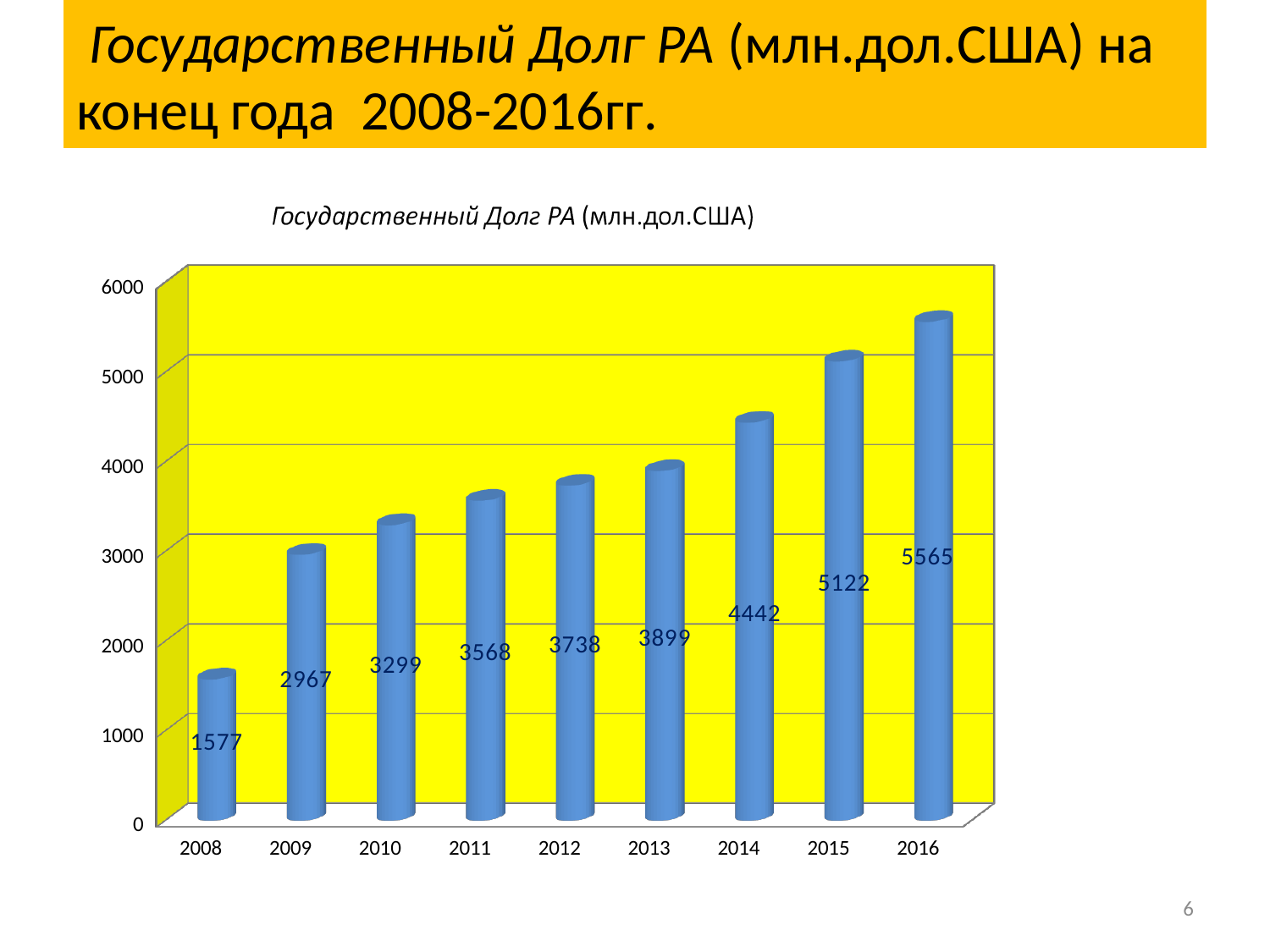
Do the values rise or fall from 2008 to 2016? rise What is the difference between the values for 2016 and 2008? 3988 What kind of chart is shown on the slide? bar chart Is the value for 2014 greater or less than 4000? greater What is the value for 2008? 1577 Which is larger, the value for 2010 or the value for 2013? 2013 Which year has the highest value? 2016 How many years are shown on the x axis? 9 What is the value for 2012? 3738 Which year has the lowest value? 2008 What is the value for 2016? 5565 What is the difference between the values for 2015 and 2014? 680